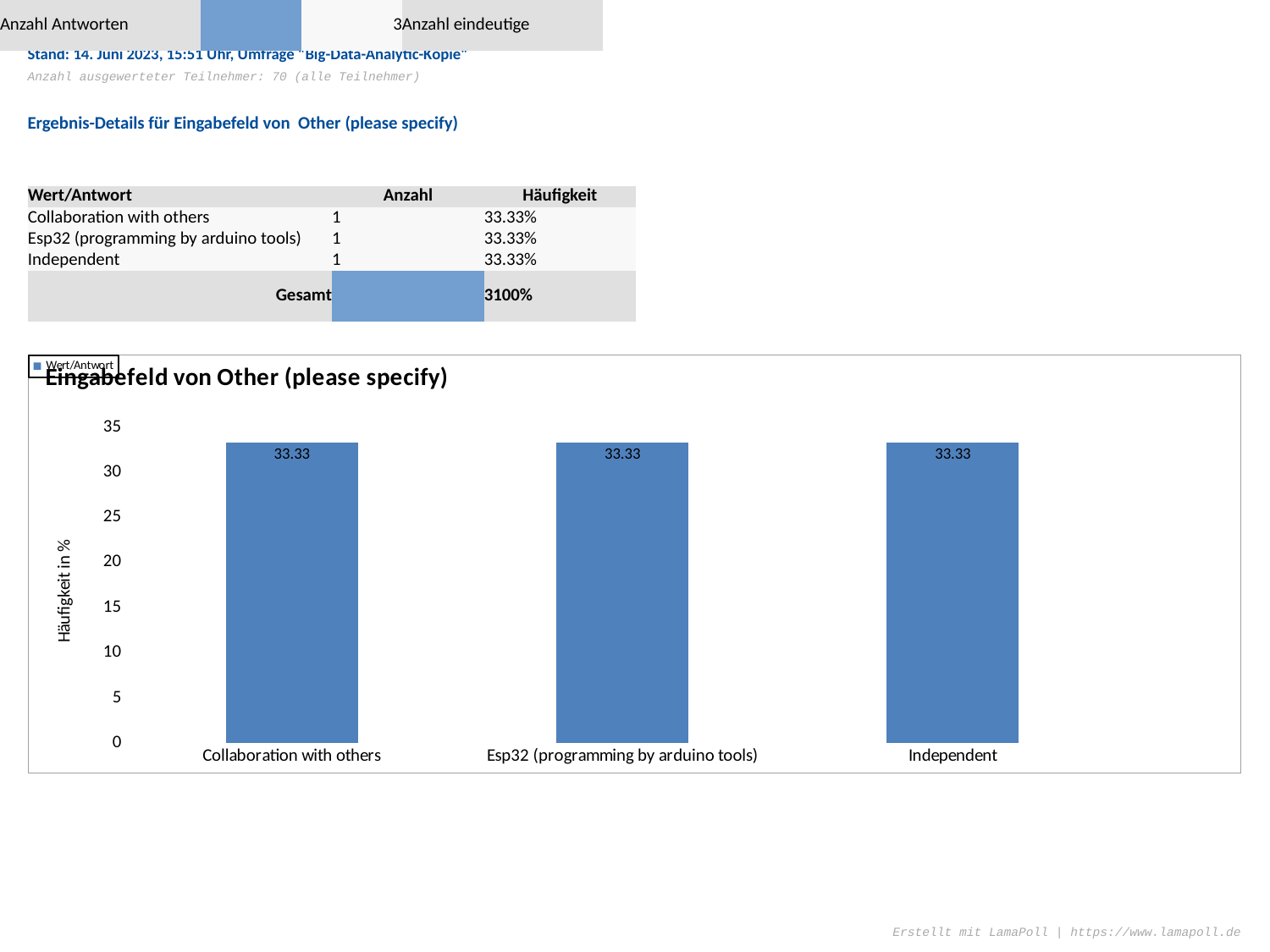
What is the value for Independent? 33.33 How many series does the chart legend list? 1 How many categories are shown on the x axis of the chart? 3 Is the value for Collaboration with others greater or less than 35? less What is the value for Collaboration with others? 33.33 What kind of chart is shown on the slide? bar chart What is the title of the chart? Eingabefeld von Other (please specify) What is the value for Esp32 (programming by arduino tools)? 33.33 What is the difference between the values for Collaboration with others and Independent? 0 Do the values rise, fall or stay the same across the categories from left to right? stay the same Is the value for Independent greater or less than 30? greater What is the label of the y axis of the chart? Häufigkeit in %